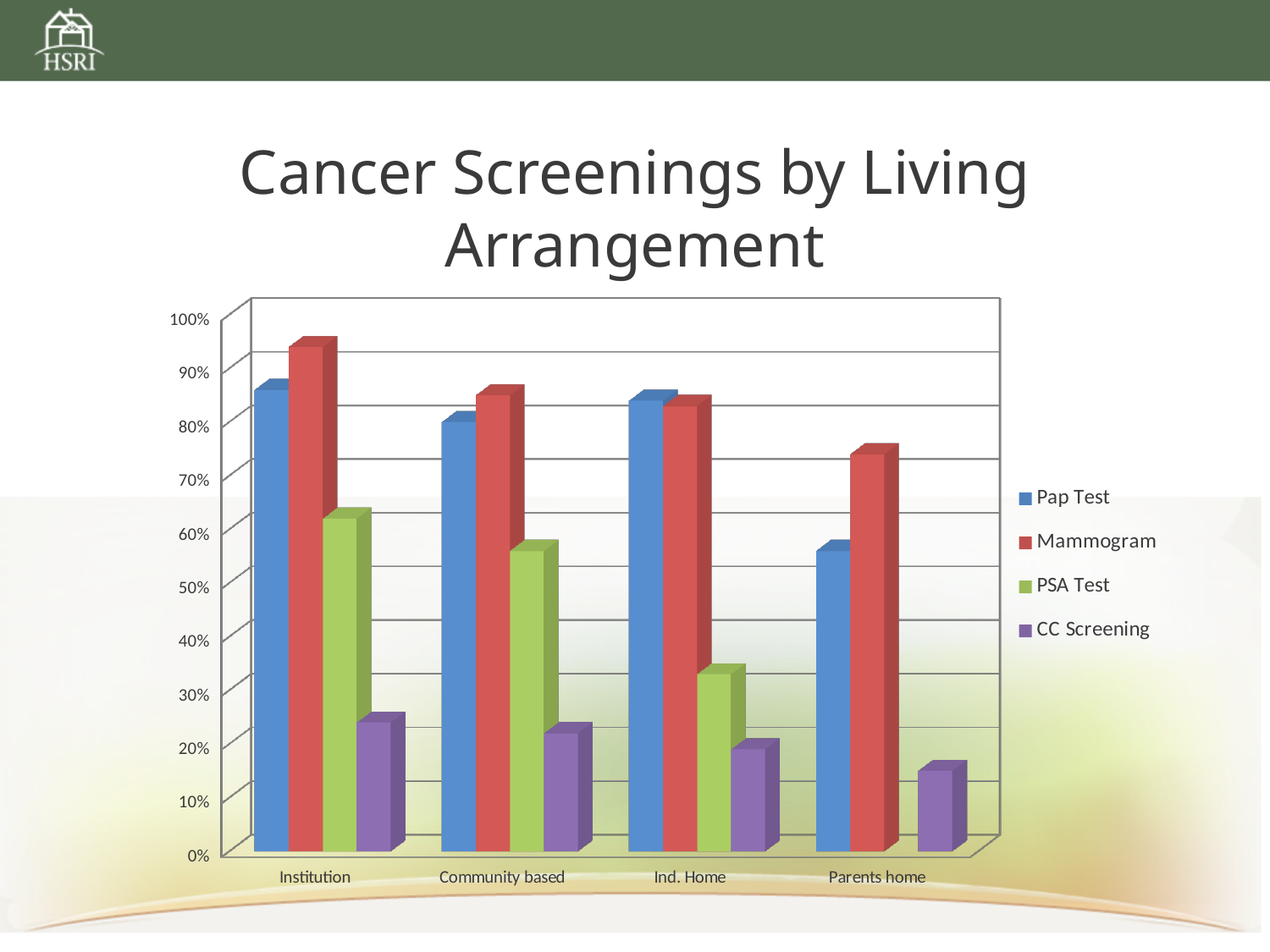
Which category has no PSA Test bar? Parents home Do the Mammogram values rise or fall moving from Institution to Parents home along the x axis? fall Is the PSA Test value for Institution greater or less than 50%? greater How many series does the legend list? 4 Is the PSA Test value for Ind. Home greater or less than 40%? less Which series has the tallest bar in the Institution category? Mammogram Which series has the lowest bar in the Parents home category? CC Screening In the Parents home category, which is larger: Pap Test or Mammogram? Mammogram In the Institution category, which is larger: Pap Test or Mammogram? Mammogram Is the Pap Test value for Parents home greater or less than 60%? less How many living arrangement categories are shown on the x axis? 4 What kind of chart is shown on the slide? Bar chart